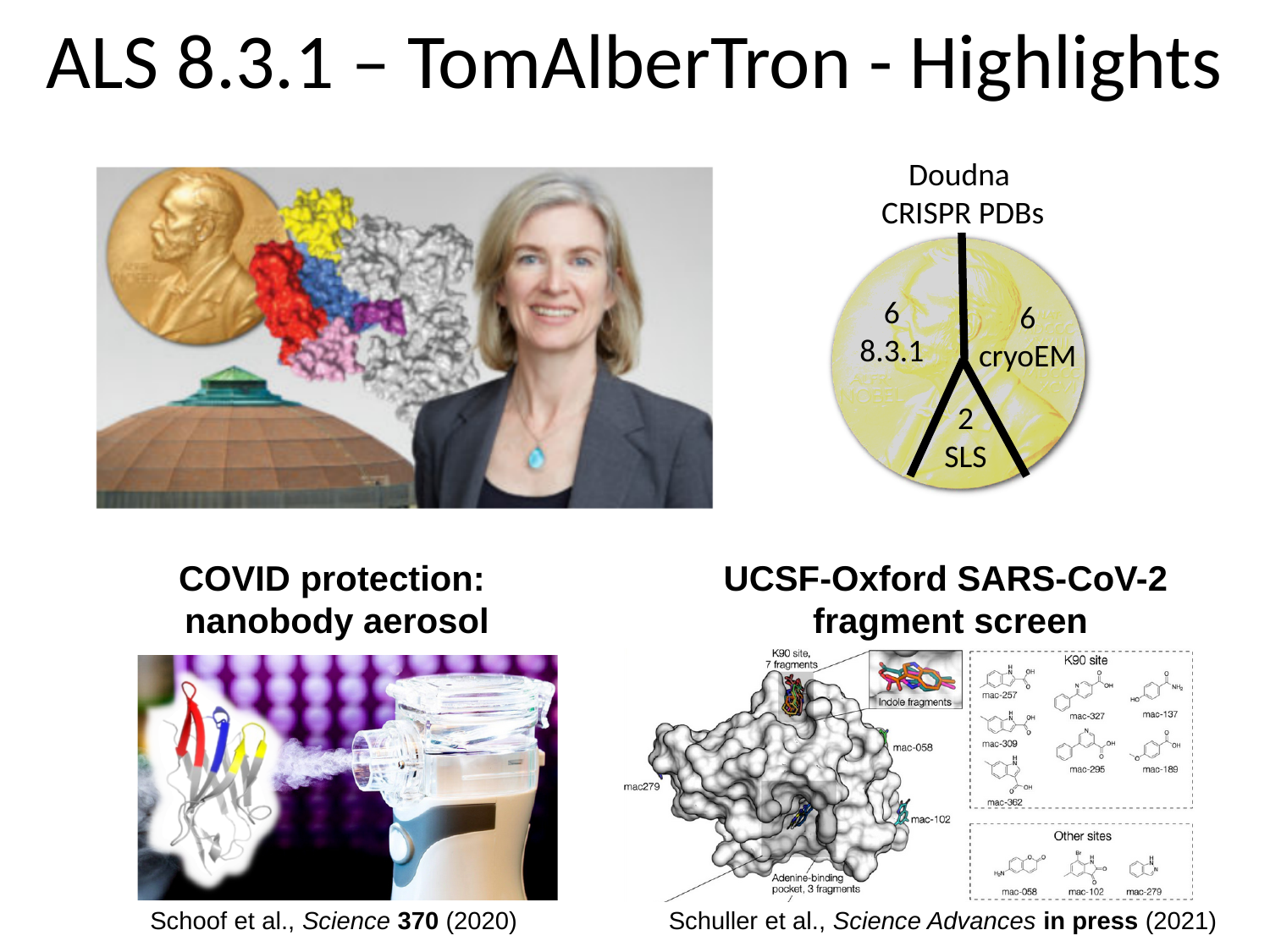
How many slices does the 'Doudna CRISPR PDBs' pie chart have? 3 In the 'Doudna CRISPR PDBs' pie chart, what is the difference between the 8.3.1 value and the SLS value? 4 In the 'Doudna CRISPR PDBs' pie chart, what is the value for cryoEM? 6 In the 'Doudna CRISPR PDBs' pie chart, what fraction of the total does the SLS slice represent? 2 of 14 Which slice of the 'Doudna CRISPR PDBs' pie chart has the smallest value? SLS What is the total of all slices in the 'Doudna CRISPR PDBs' pie chart? 14 In the 'Doudna CRISPR PDBs' pie chart, what is the value for 8.3.1? 6 What is the title written above the pie chart on the slide? Doudna CRISPR PDBs What kind of chart is shown under the heading 'Doudna CRISPR PDBs'? pie chart In the 'Doudna CRISPR PDBs' pie chart, which is larger: 8.3.1 or SLS? 8.3.1 What image is used as the background of the 'Doudna CRISPR PDBs' pie chart? a Nobel medal In the 'Doudna CRISPR PDBs' pie chart, what is the value for SLS? 2